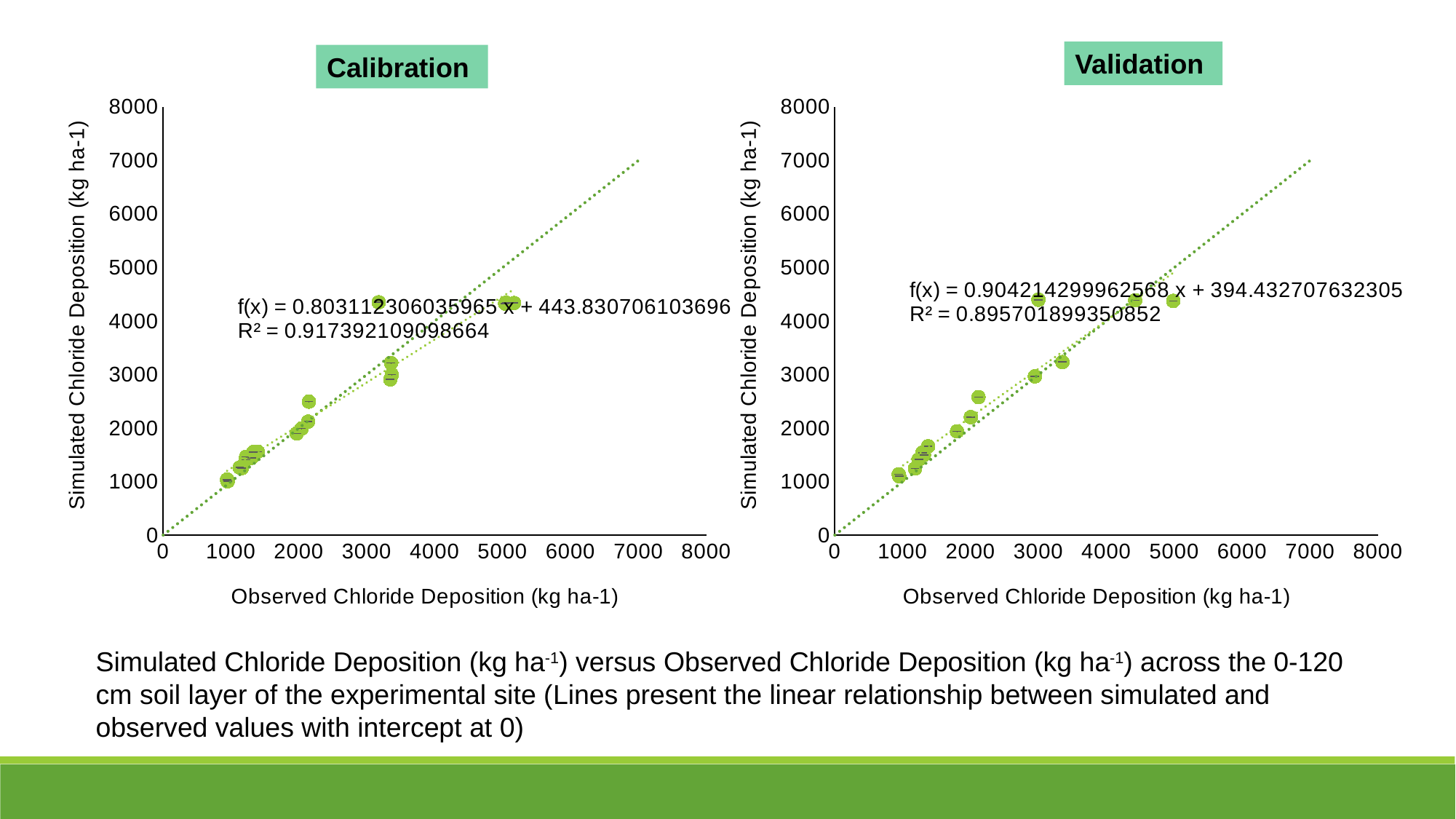
On the Validation chart, is the slope of the fitted line greater or less than 0.9? greater What kind of chart is the Calibration chart? scatter chart What is the maximum value shown on the y axis of the Validation chart? 8000 On the Validation chart, do the simulated values generally rise or fall as observed values increase? rise On the Validation chart, is the simulated value of the point with the lowest observed value greater or less than 2000? less What is the R² value shown on the Validation chart? 0.895701899350852 What is the x-axis title of the Calibration chart? Observed Chloride Deposition (kg ha-1) What is the slope of the fitted line f(x) shown on the Calibration chart? 0.803112306035965 What is the intercept of the fitted line f(x) shown on the Validation chart? 394.432707632305 Which chart shows the higher R² value, Calibration or Validation? Calibration On the Calibration chart, is the simulated value of the point with the highest observed value greater or less than 4000? greater What is the R² value shown on the Calibration chart? 0.917392109098664